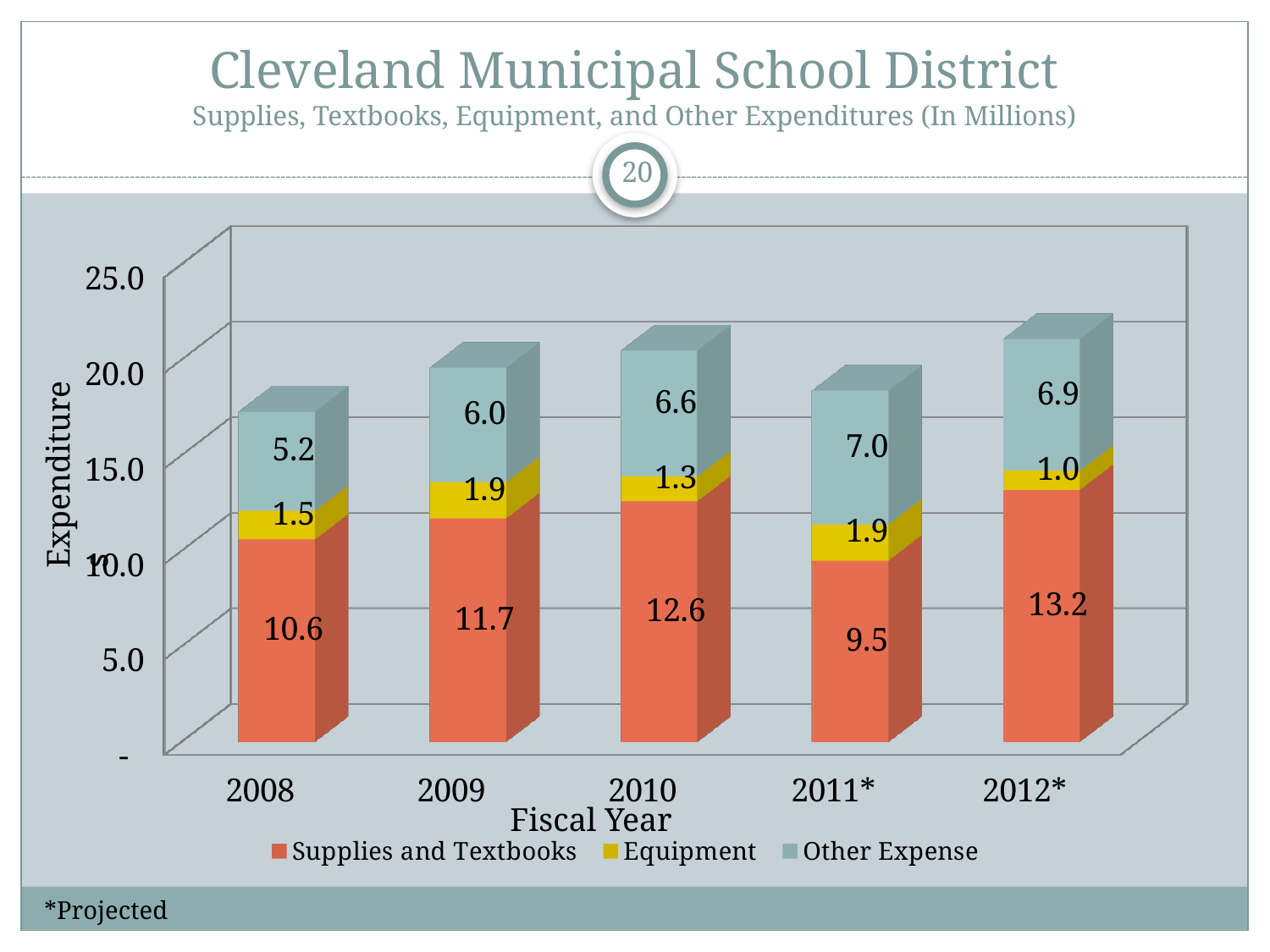
What is the difference between the Supplies and Textbooks values for 2012* and 2011*? 3.7 What kind of chart is shown on the slide? Stacked bar chart Which fiscal year has the lowest Other Expense value? 2008 What is the total of the stacked bar for fiscal year 2008? 17.3 What is the Equipment value for fiscal year 2012*? 1.0 What is the Supplies and Textbooks value for fiscal year 2010? 12.6 How many fiscal years are shown on the x axis? 5 What is the label of the y axis? Expenditure Which is larger, the Equipment value for 2009 or for 2010? 2009 How many series does the legend list? 3 Which fiscal year has the highest Supplies and Textbooks value? 2012* What is the Other Expense value for fiscal year 2011*? 7.0